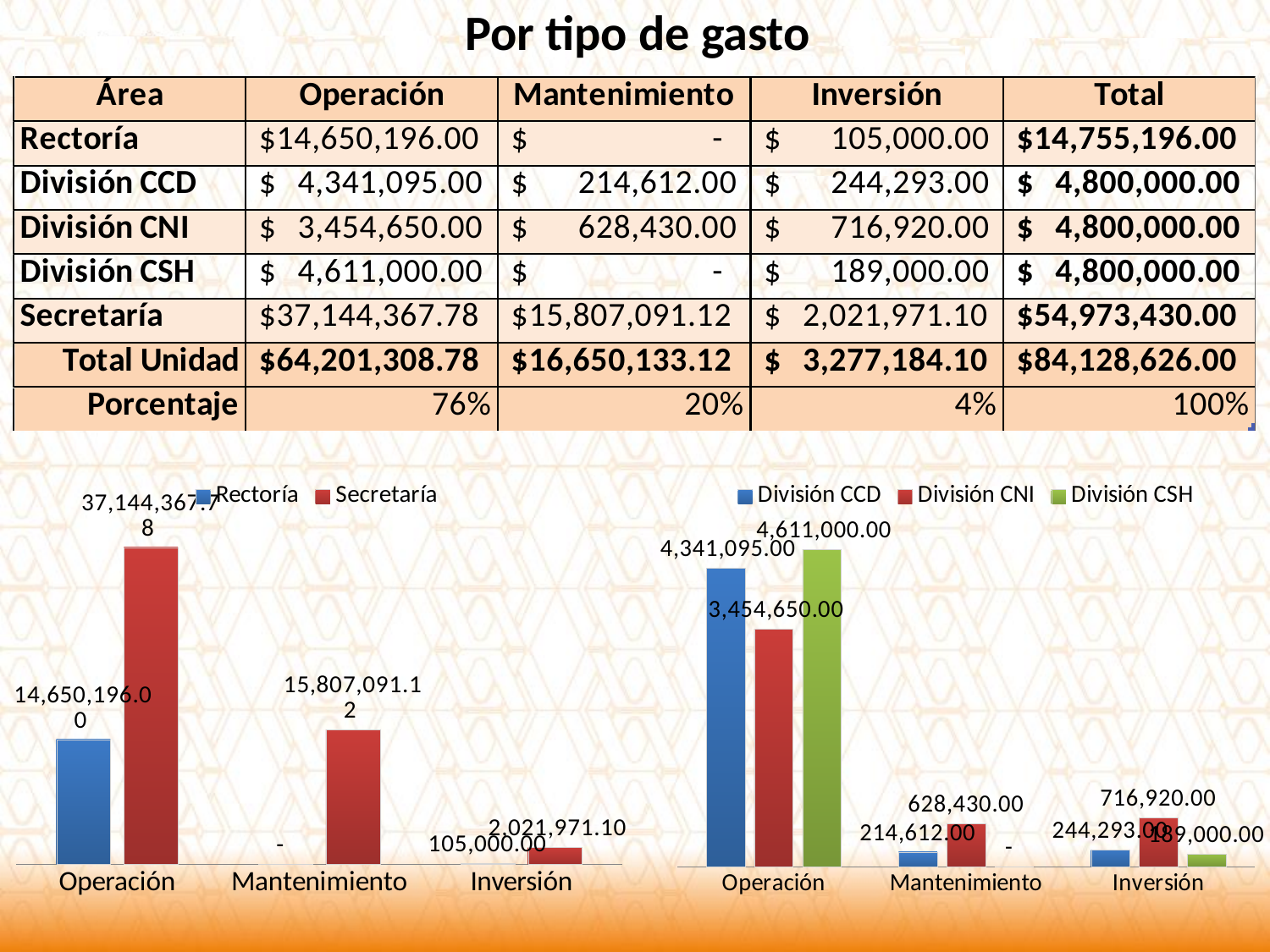
What kind of chart is the right chart? Bar chart On the right chart, how many series does the legend list? 3 On the left chart, what is the value for Rectoría in Operación? 14,650,196.00 On the left chart, what is the value for Secretaría in Operación? 37,144,367.78 On the right chart, which series has the highest value in Operación? División CSH On the right chart, what is the value for División CNI in Inversión? 716,920.00 On the left chart, what is the value for Secretaría in Mantenimiento? 15,807,091.12 On the right chart, how many categories are shown on the x axis? 3 On the left chart, which series has the larger value in Inversión, Rectoría or Secretaría? Secretaría On the right chart, what is the value for División CNI in Operación? 3,454,650.00 On the left chart, how many series does the legend list? 2 On the right chart, which series has the lowest value in Inversión? División CSH